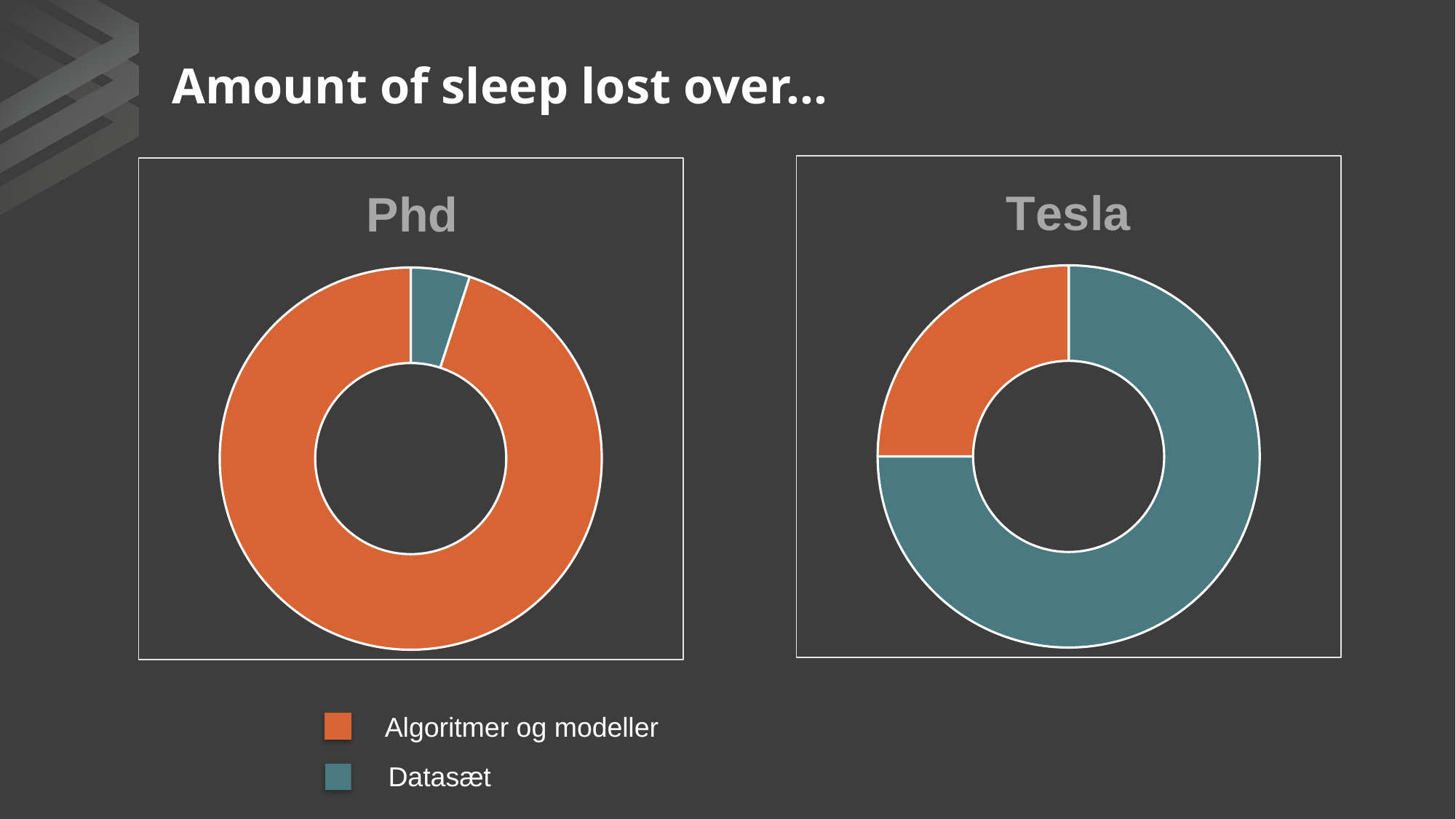
What colour represents Datasæt in the charts? Teal In the "Phd" chart, which category has the smallest share? Datasæt In the "Tesla" chart, which category has the largest share? Datasæt In the "Phd" chart, which category has the largest share? Algoritmer og modeller In the "Tesla" chart, which is larger: Algoritmer og modeller or Datasæt? Datasæt What kind of chart is the "Phd" chart? Doughnut chart What is the title of the slide containing the two charts? Amount of sleep lost over… In the "Phd" chart, which is larger: Algoritmer og modeller or Datasæt? Algoritmer og modeller What kind of chart is the "Tesla" chart? Doughnut chart How many slices does the "Phd" chart have? 2 In the "Tesla" chart, which category has the smallest share? Algoritmer og modeller How many entries does the shared legend list? 2